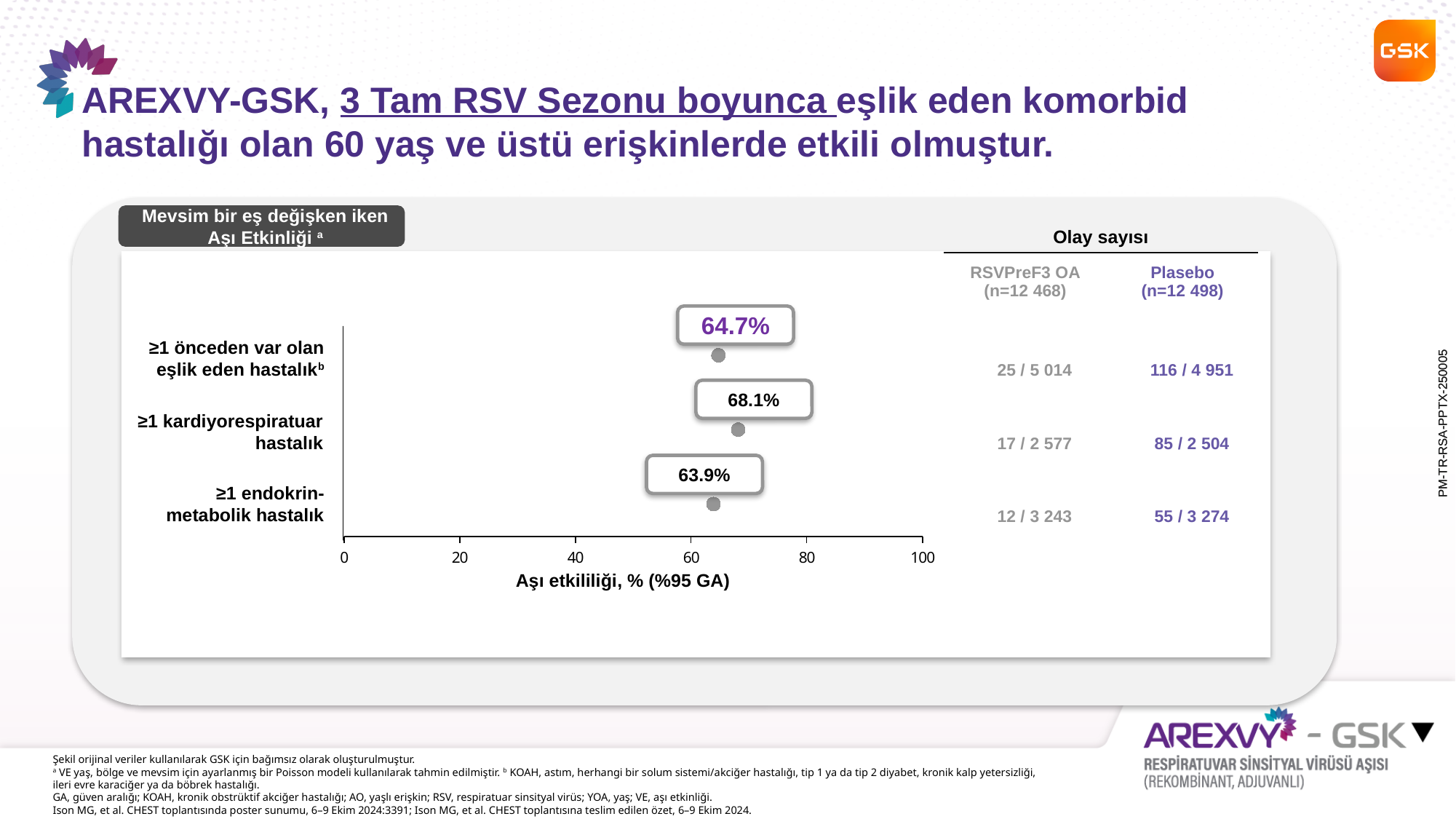
How many categories are plotted on the chart? 3 Which category has the lowest vaccine efficacy value on the chart? ≥1 endokrin-metabolik hastalık Which is larger: the vaccine efficacy for ≥1 önceden var olan eşlik eden hastalık or for ≥1 endokrin-metabolik hastalık? ≥1 önceden var olan eşlik eden hastalık What is the vaccine efficacy value shown for ≥1 önceden var olan eşlik eden hastalık? 64.7% What is the difference between the vaccine efficacy values for ≥1 kardiyorespiratuar hastalık and ≥1 endokrin-metabolik hastalık? 4.2 percentage points What is the vaccine efficacy value shown for ≥1 endokrin-metabolik hastalık? 63.9% Which category has the highest vaccine efficacy value on the chart? ≥1 kardiyorespiratuar hastalık What is the vaccine efficacy value shown for ≥1 kardiyorespiratuar hastalık? 68.1% What is the label of the x axis of the chart? Aşı etkililiği, % (%95 GA) In the Olay sayısı table, what is the Plasebo value for ≥1 kardiyorespiratuar hastalık? 85 / 2 504 What is the difference between the vaccine efficacy values for ≥1 kardiyorespiratuar hastalık and ≥1 önceden var olan eşlik eden hastalık? 3.4 percentage points Is the vaccine efficacy value for ≥1 endokrin-metabolik hastalık greater or less than 60? greater